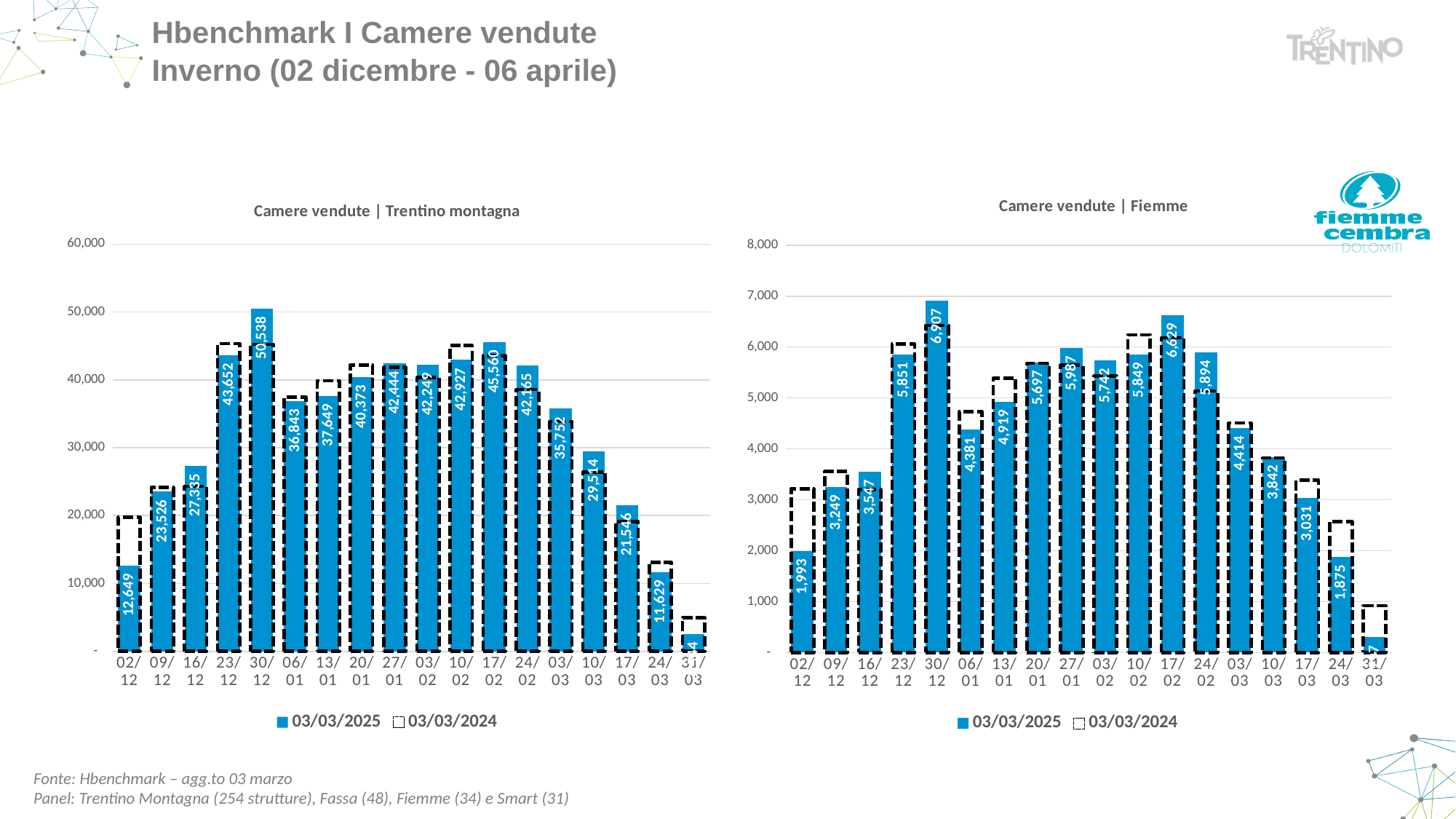
In the 'Camere vendute | Fiemme' chart, which is larger for 03/03/2025: 23/12 or 06/01? 23/12 In the 'Camere vendute | Trentino montagna' chart, what is the difference between the 03/03/2025 values for 17/02 and 24/02? 3,395 In the 'Camere vendute | Fiemme' chart, what is the difference between the 03/03/2025 values for 17/02 and 24/02? 735 In the 'Camere vendute | Trentino montagna' chart, what is the 03/03/2025 value for 02/12? 12,649 How many series does the legend of the 'Camere vendute | Fiemme' chart list? 2 In the 'Camere vendute | Fiemme' chart, what is the 03/03/2025 value for 17/03? 3,031 In the 'Camere vendute | Trentino montagna' chart, which week has the highest 03/03/2025 value? 30/12 In the 'Camere vendute | Trentino montagna' chart, what is the 03/03/2025 value for 30/12? 50,538 In the 'Camere vendute | Trentino montagna' chart, do the 03/03/2025 values rise or fall from 03/03 to 24/03? Fall In the 'Camere vendute | Trentino montagna' chart, is the 03/03/2025 value for 24/03 greater or less than 20,000? less What kind of chart is 'Camere vendute | Trentino montagna'? Bar chart In the 'Camere vendute | Fiemme' chart, what is the 03/03/2025 value for 30/12? 6,907